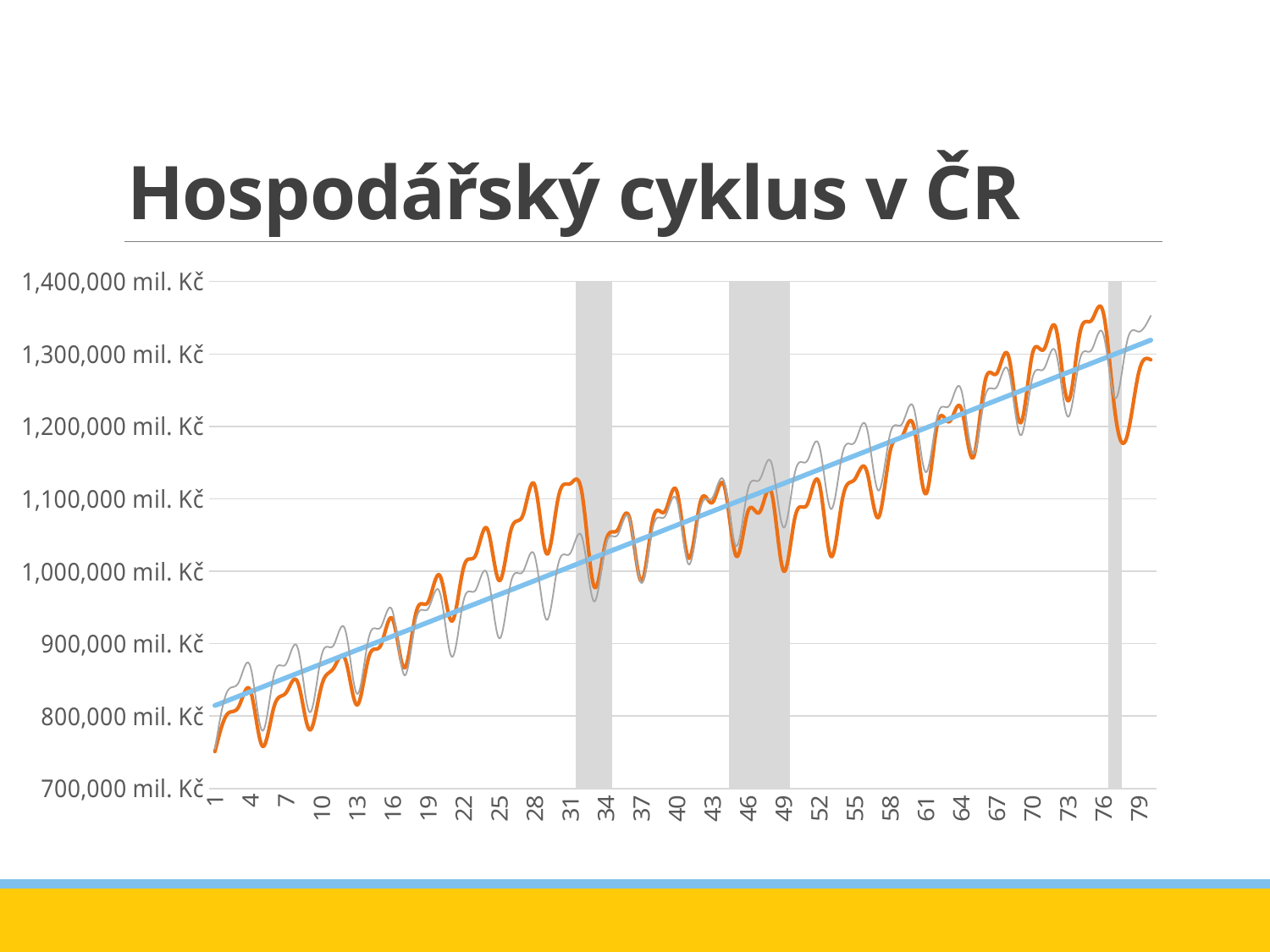
Is the value of the orange line at point 61 greater or less than 1,300,000 mil. Kč? less Is the value of the orange line at point 79 greater or less than 1,200,000 mil. Kč? greater How many grey shaded vertical bands are drawn on the chart? 3 What is the title of the chart? Hospodářský cyklus v ČR Is the value of the orange line at point 34 greater or less than 1,100,000 mil. Kč? less Which is larger for the orange line: the value at point 1 or the value at point 79? point 79 Do the plotted values generally rise or fall along the x axis? rise What kind of chart is shown on the slide? line chart Which is larger for the orange line: the value at point 13 or the value at point 52? point 52